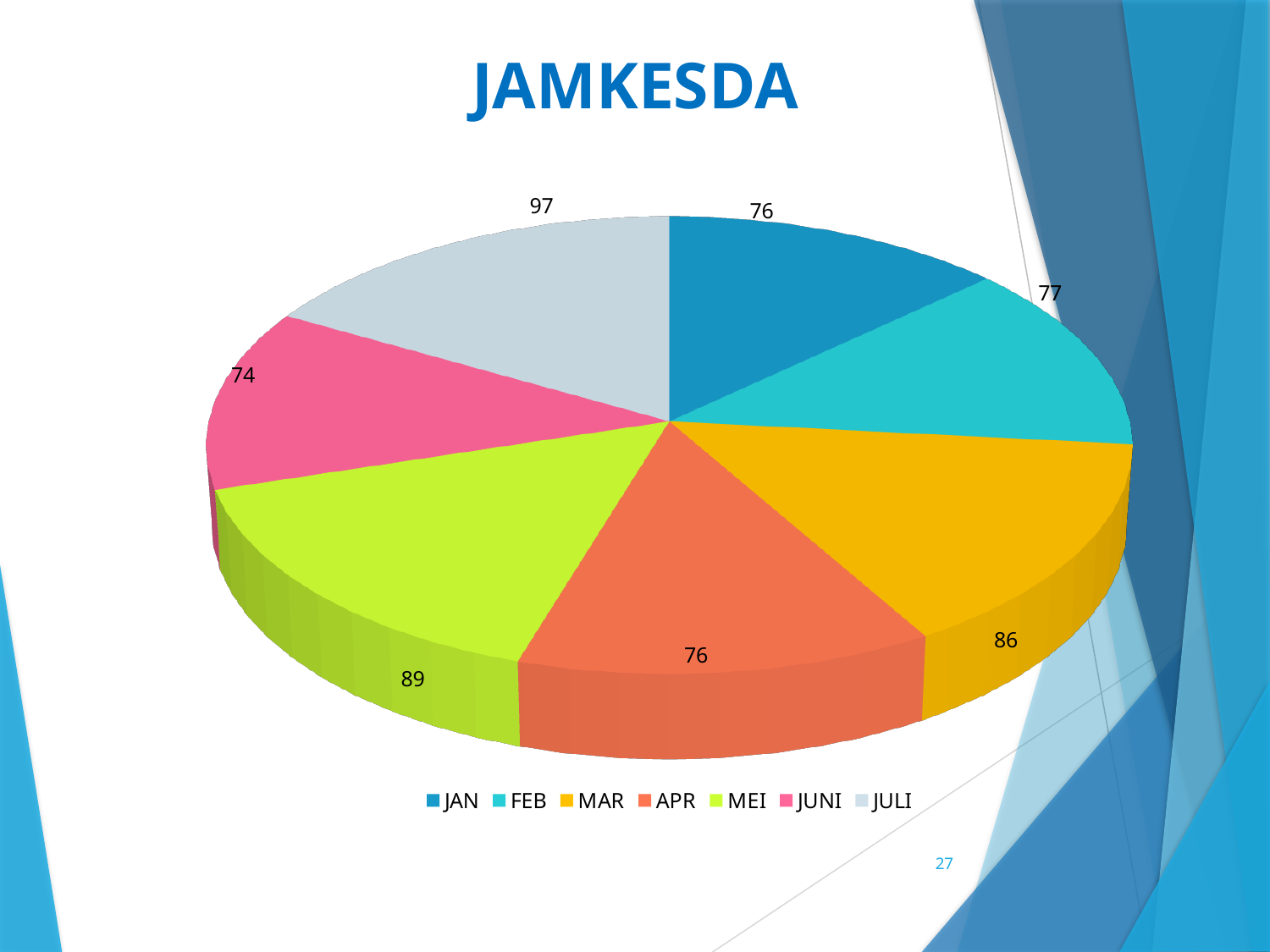
What is the difference between the values for MEI and MAR in the JAMKESDA pie chart? 3 How many slices does the JAMKESDA pie chart have? 7 Which month has the smallest slice in the JAMKESDA pie chart? JUNI What is the value for JUNI in the JAMKESDA pie chart? 74 Which month has the largest slice in the JAMKESDA pie chart? JULI What is the value for MAR in the JAMKESDA pie chart? 86 What is the difference between the values for JULI and JUNI in the JAMKESDA pie chart? 23 What is the title of the chart on the slide? JAMKESDA Which is larger in the JAMKESDA pie chart, the value for MAR or the value for FEB? MAR What kind of chart is shown on the slide? Pie chart What is the value for FEB in the JAMKESDA pie chart? 77 What is the value for JULI in the JAMKESDA pie chart? 97